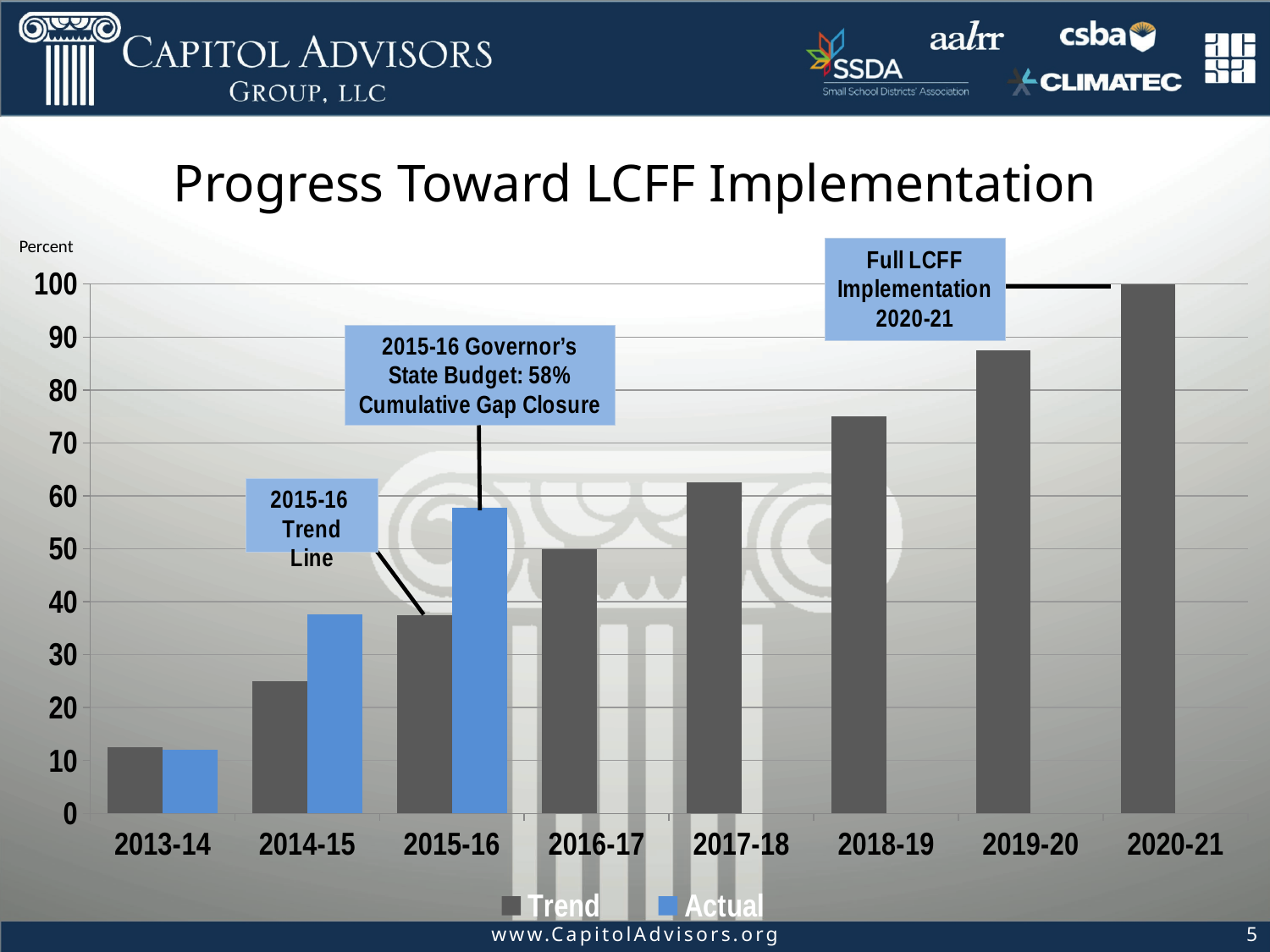
For 2015-16, which is larger, the Trend bar or the Actual bar? Actual How many fiscal years are shown on the x axis? 8 Do the Trend values rise or fall from 2013-14 to 2020-21? rise What type of chart is shown on the slide? bar chart Which year has the highest Trend bar? 2020-21 What is the Actual value for 2015-16, as given in the callout? 58% What are the two series named in the legend? Trend and Actual How many series does the legend list? 2 Is the Trend value for 2018-19 greater or less than 70? greater What is the Trend value for 2016-17? 50 Which year has the lowest Trend bar? 2013-14 What is the Trend value for 2020-21? 100